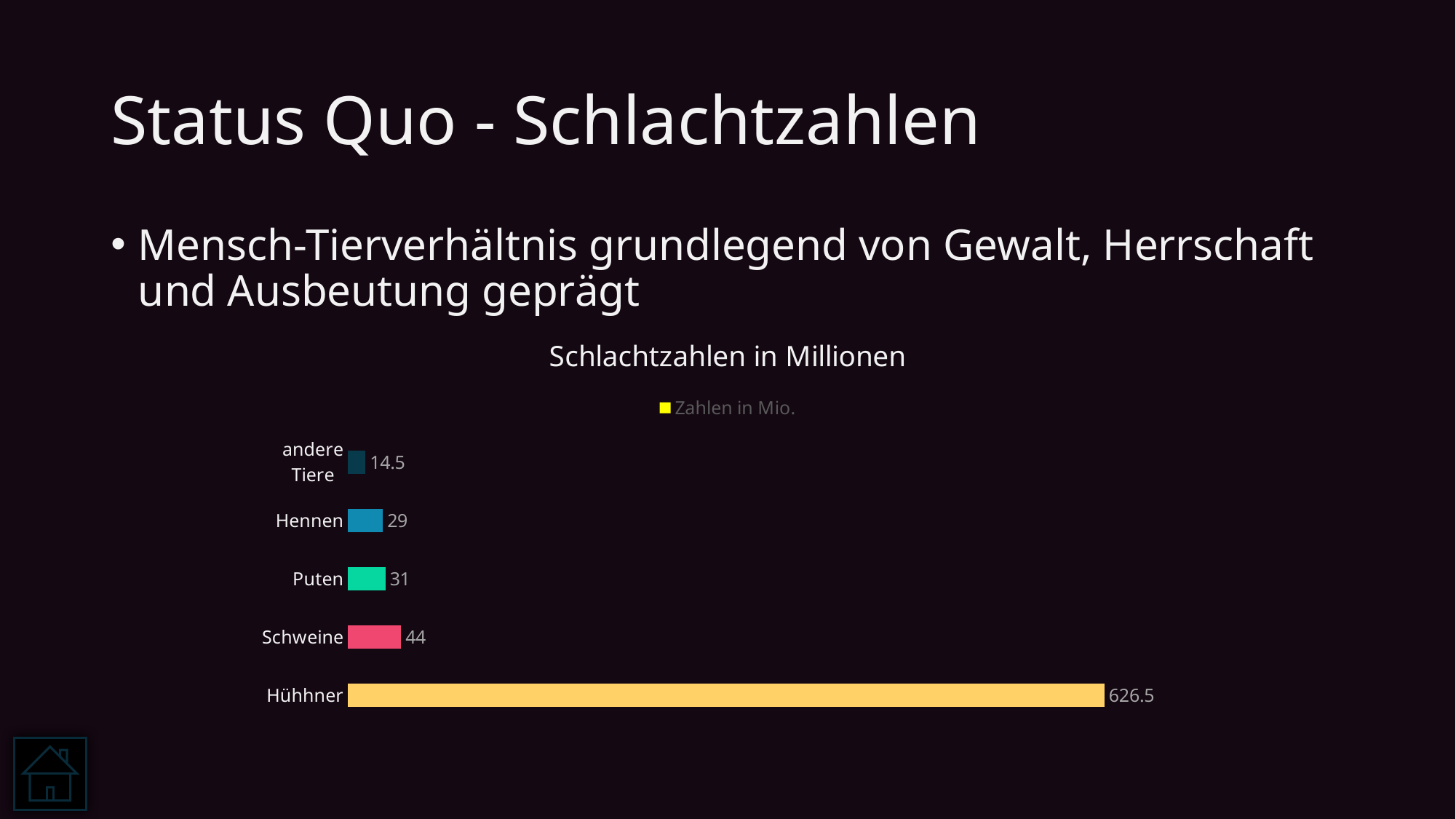
Which category has the lowest value? andere Tiere What kind of chart is shown on the slide? Bar chart How many categories are shown in the chart? 5 What is the difference between the values for Puten and Hennen? 2 What is the difference between the values for Hühhner and Schweine? 582.5 What is the value for Hühhner in the chart? 626.5 What is the value for Hennen? 29 What is the value for Schweine? 44 Which is larger, the value for Schweine or the value for Puten? Schweine What is the title of the chart? Schlachtzahlen in Millionen What is the value for andere Tiere? 14.5 Which category has the highest value? Hühhner